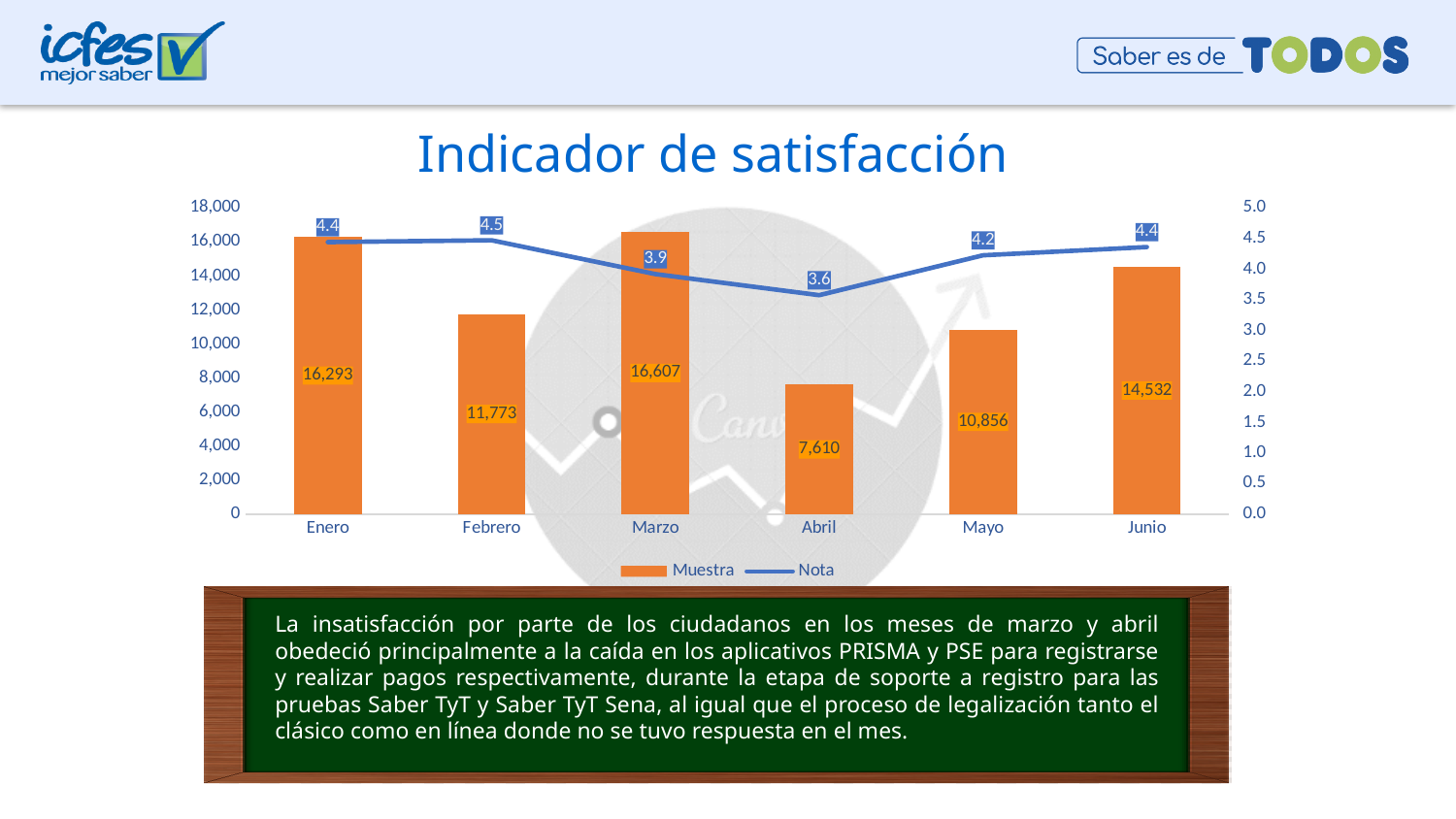
Which month has a larger Muestra value, Mayo or Junio? Junio Is the Muestra value for Abril greater or less than 8,000? less Which month has the highest Muestra value? Marzo What is the Muestra value for Junio? 14,532 How many months are shown on the x axis? 6 What is the Muestra value for Marzo? 16,607 What is the title of the chart? Indicador de satisfacción What is the Nota value for Abril? 3.6 Which month has the lowest Nota value? Abril What is the Nota value for Febrero? 4.5 How many series does the legend list? 2 What is the difference between the Muestra values for Enero and Febrero? 4,520